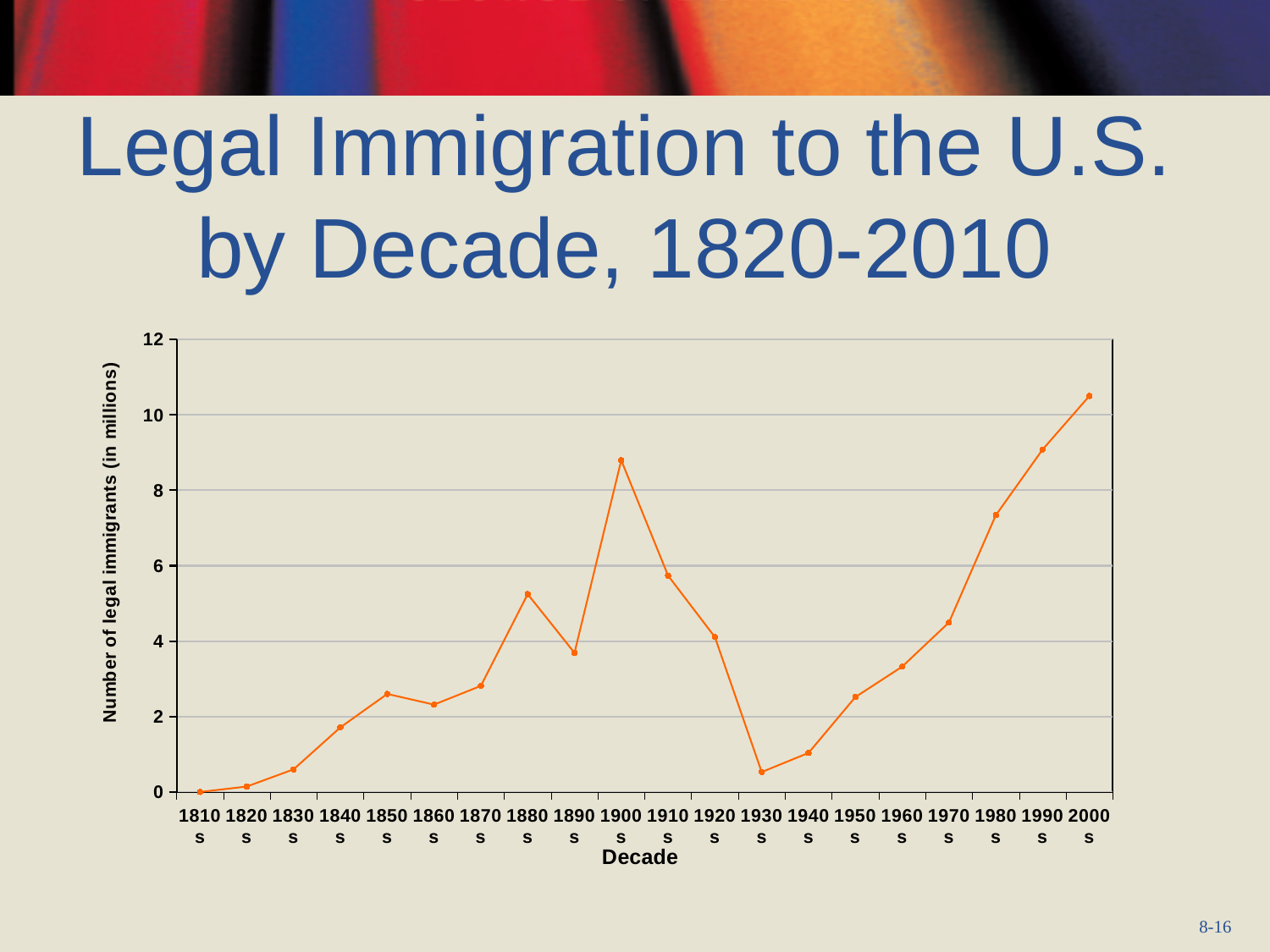
Is the value for the 1930s greater or less than 2? less Which decade has a larger value, the 1880s or the 1900s? 1900s Is the value for the 1900s greater or less than 8? greater How many decades are plotted on the x axis? 20 Is the value for the 2000s greater or less than 10? greater Which decade has the highest number of legal immigrants? 2000s What is the label of the y axis? Number of legal immigrants (in millions) Do the values rise or fall from the 1900s to the 1930s? fall Which decade has the lowest number of legal immigrants? 1810s What kind of chart is shown on the slide? line chart Which decade has a larger value, the 1890s or the 1910s? 1910s